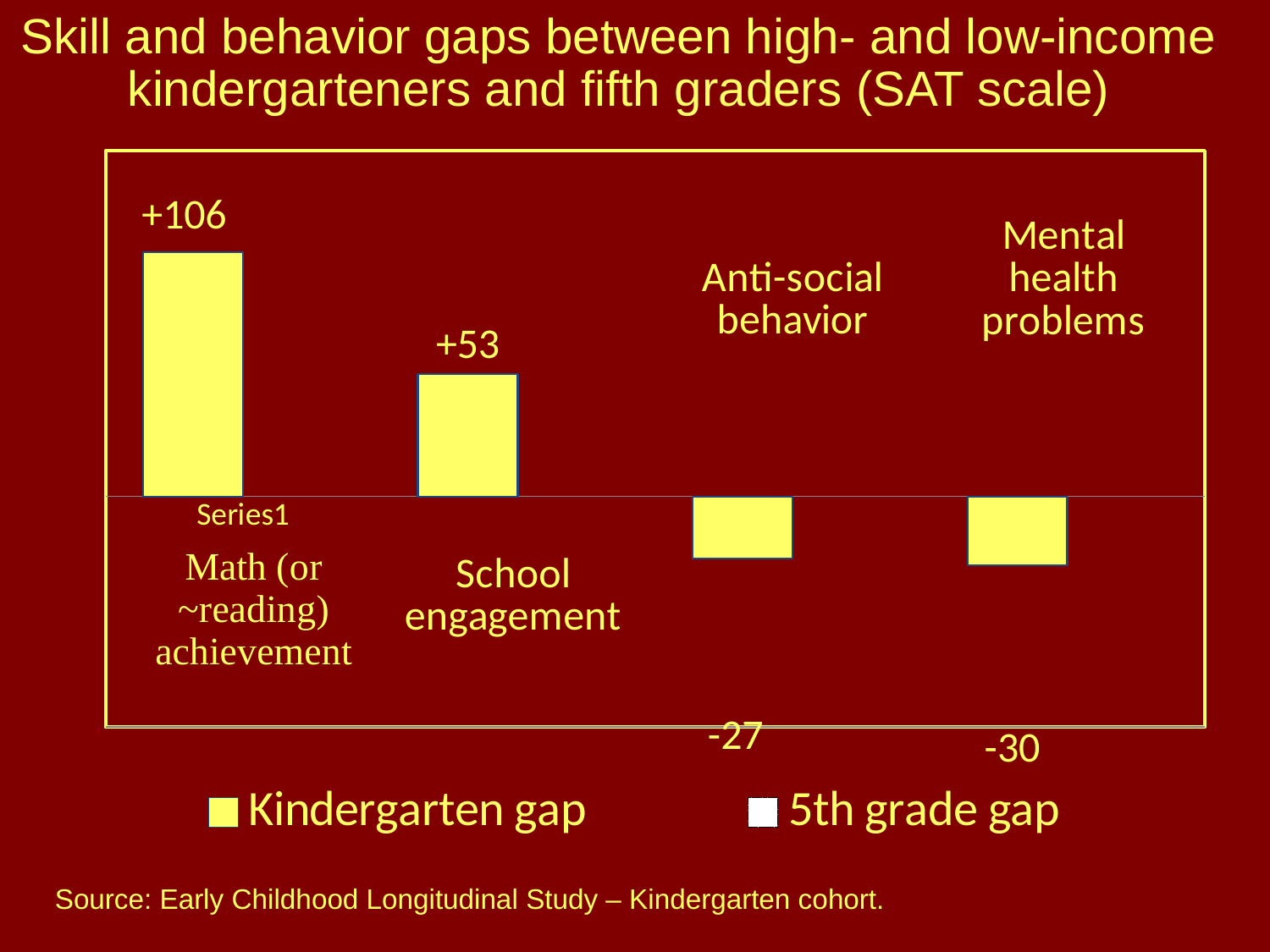
What is the kindergarten gap value for Math (or ~reading) achievement? +106 What kind of chart is shown on the slide? Bar chart How many categories are shown in the chart? 4 What is the kindergarten gap value for Mental health problems? -30 Which category has the lowest kindergarten gap value? Mental health problems Which category has the highest kindergarten gap value? Math (or ~reading) achievement What is the kindergarten gap value for School engagement? +53 What is the kindergarten gap value for Anti-social behavior? -27 Which is larger, the kindergarten gap for School engagement or for Anti-social behavior? School engagement What is the difference between the kindergarten gap for Math (or ~reading) achievement and for School engagement? 53 What are the two series named in the legend? Kindergarten gap and 5th grade gap How many series does the legend list? 2